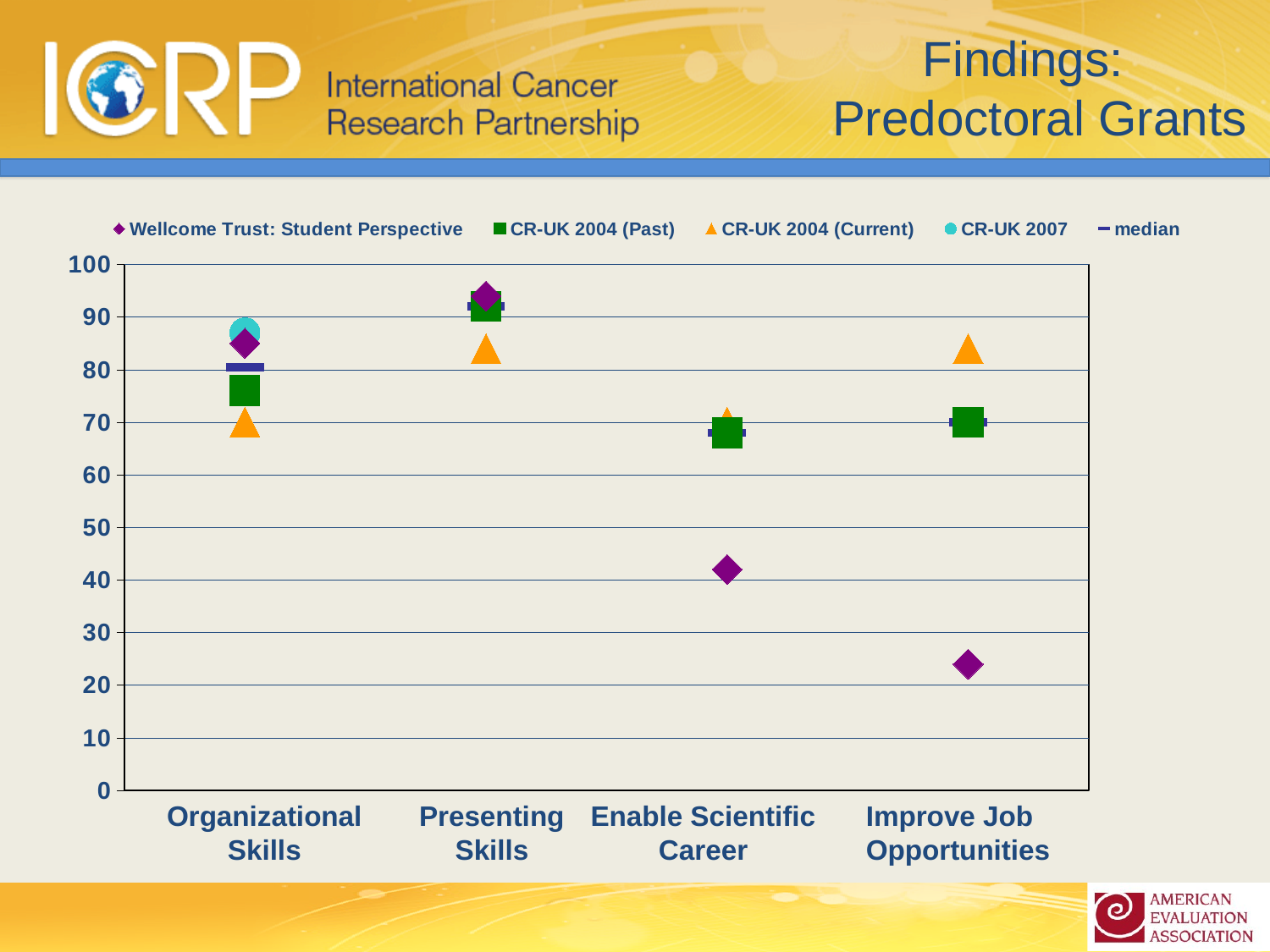
Is the Wellcome Trust: Student Perspective value for Enable Scientific Career greater or less than 50? less How many series does the chart legend list? 5 Which category has the highest Wellcome Trust: Student Perspective value? Presenting Skills Is the Wellcome Trust: Student Perspective value for Improve Job Opportunities greater or less than 30? less Which category has the lowest Wellcome Trust: Student Perspective value? Improve Job Opportunities What kind of chart is shown on the slide? scatter chart For Enable Scientific Career, which is larger: the Wellcome Trust: Student Perspective value or the CR-UK 2004 (Past) value? CR-UK 2004 (Past) How many categories are shown on the x axis of the chart? 4 Is the CR-UK 2004 (Current) value for Improve Job Opportunities greater or less than 80? greater